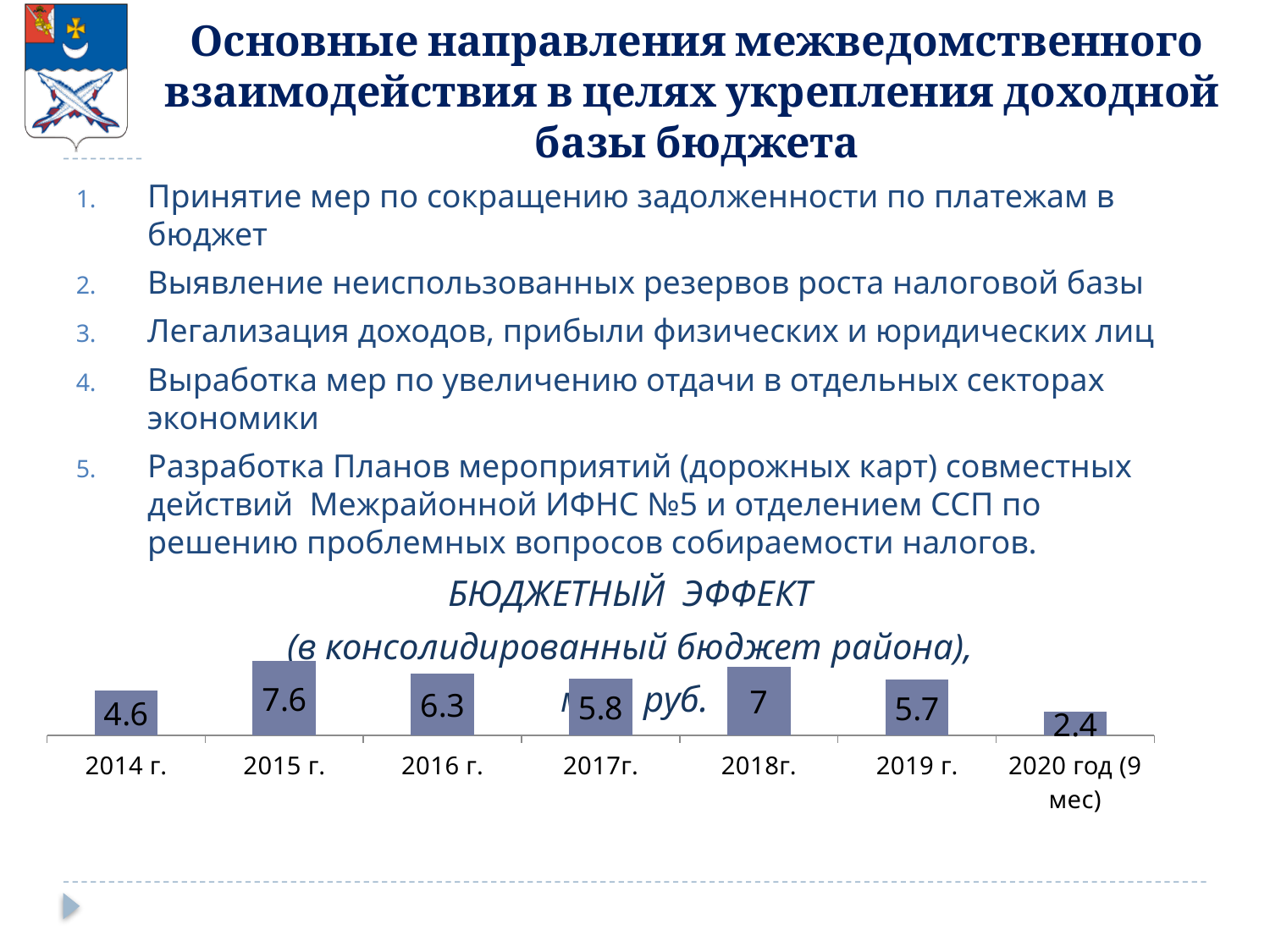
What is the value for 2020 год (9 мес)? 2.4 What is the difference between the values for 2017г. and 2020 год (9 мес)? 3.4 What kind of chart is shown on the slide? bar chart Which category has the lowest value? 2020 год (9 мес) What is the value for 2015 г.? 7.6 What is the difference between the values for 2015 г. and 2014 г.? 3 Which is larger, the value for 2016 г. or the value for 2019 г.? 2016 г. What is the value for 2018г.? 7 Which year has the highest value? 2015 г. How many categories are shown on the x axis? 7 What is the value for 2014 г.? 4.6 Do the values rise or fall from 2018г. to 2020 год (9 мес)? fall